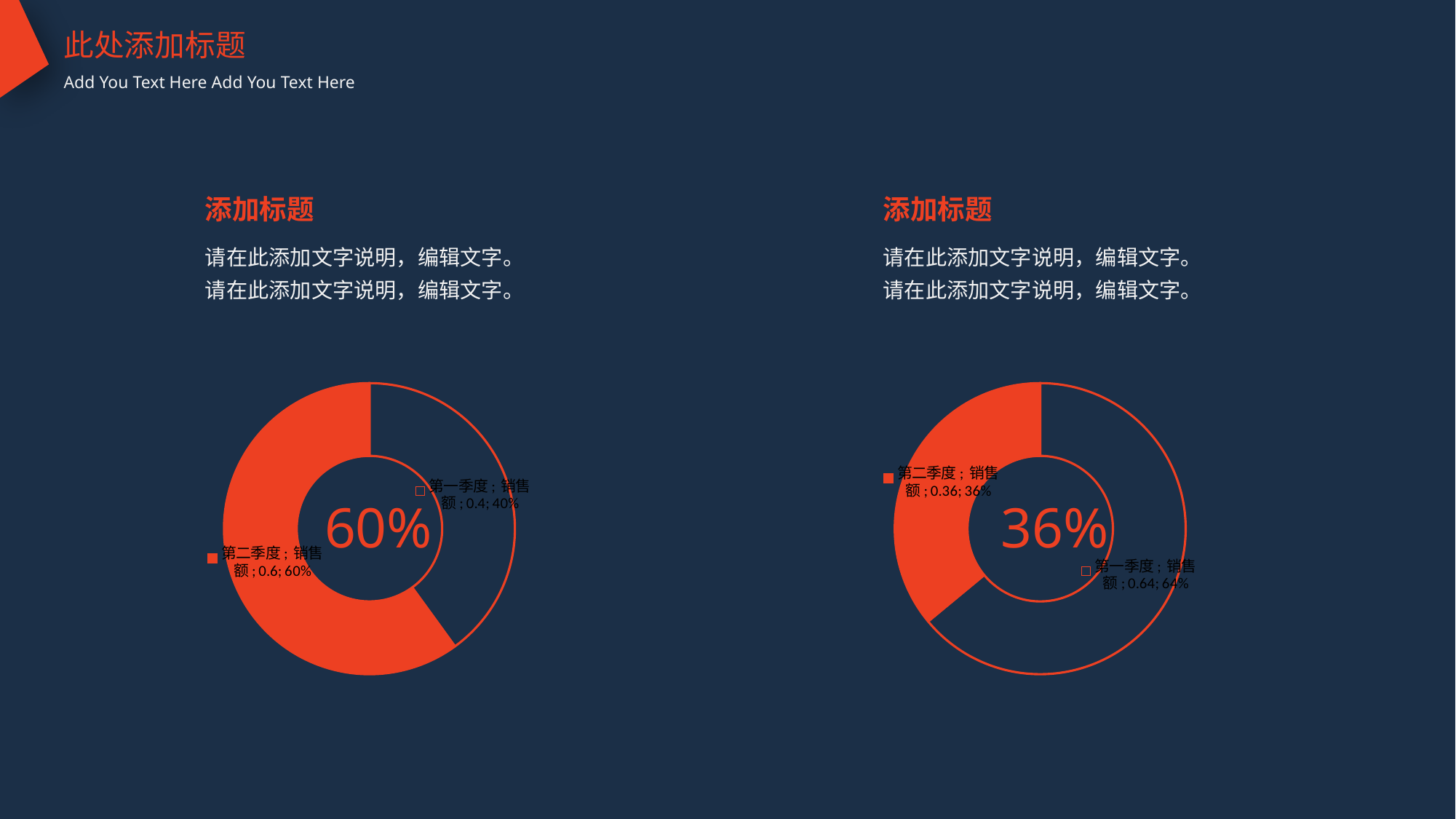
What number is printed in the centre of the right chart? 36% In the right chart, which category has the smaller share? 第二季度 In the right chart, what percentage is shown for 第二季度? 36% What type of chart is the right chart? doughnut chart In the right chart, what is the difference in percentage points between 第一季度 and 第二季度? 28 In the left chart, what percentage is shown for 第一季度? 40% How many categories does the left chart show? 2 In the left chart, what percentage is shown for 第二季度? 60% In the left chart, what is the difference in percentage points between 第二季度 and 第一季度? 20 In the right chart, what percentage is shown for 第一季度? 64% Is the share of 第二季度 larger in the left chart or the right chart? left chart In the left chart, which category has the larger share? 第二季度